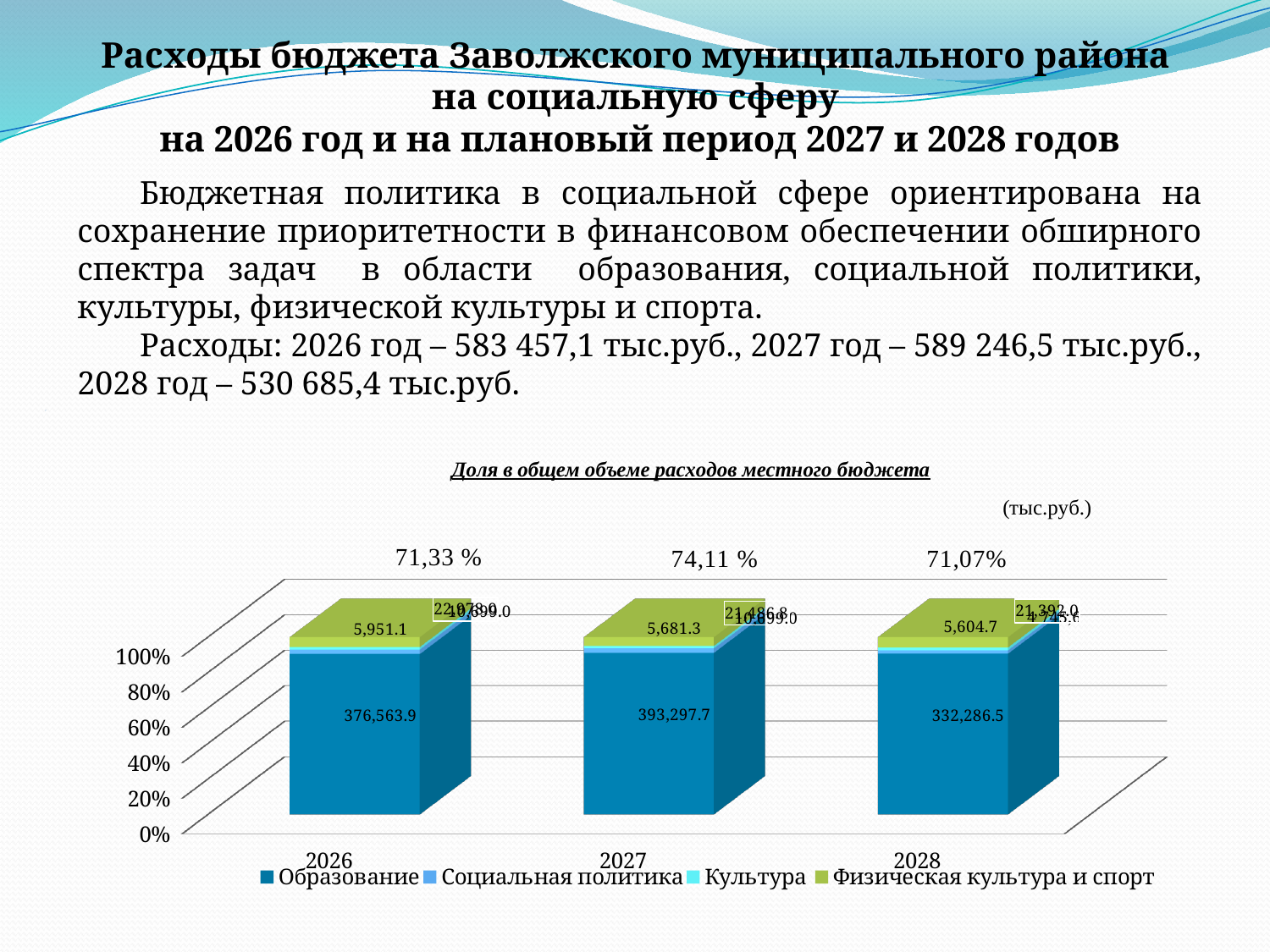
What is the value for Образование in 2028? 332,286.5 In which year is the value for Образование the lowest? 2028 What is the difference between the Образование values for 2027 and 2026? 16,733.8 How many series does the chart legend list? 4 What is the value for Образование in 2027? 393,297.7 How many years are shown on the x axis of the chart? 3 What is the value for Социальная политика in 2026? 10,699.0 What is the value for Образование in 2026? 376,563.9 In which year is the value for Образование the highest? 2027 What percentage is shown above the 2027 bar? 74,11 %